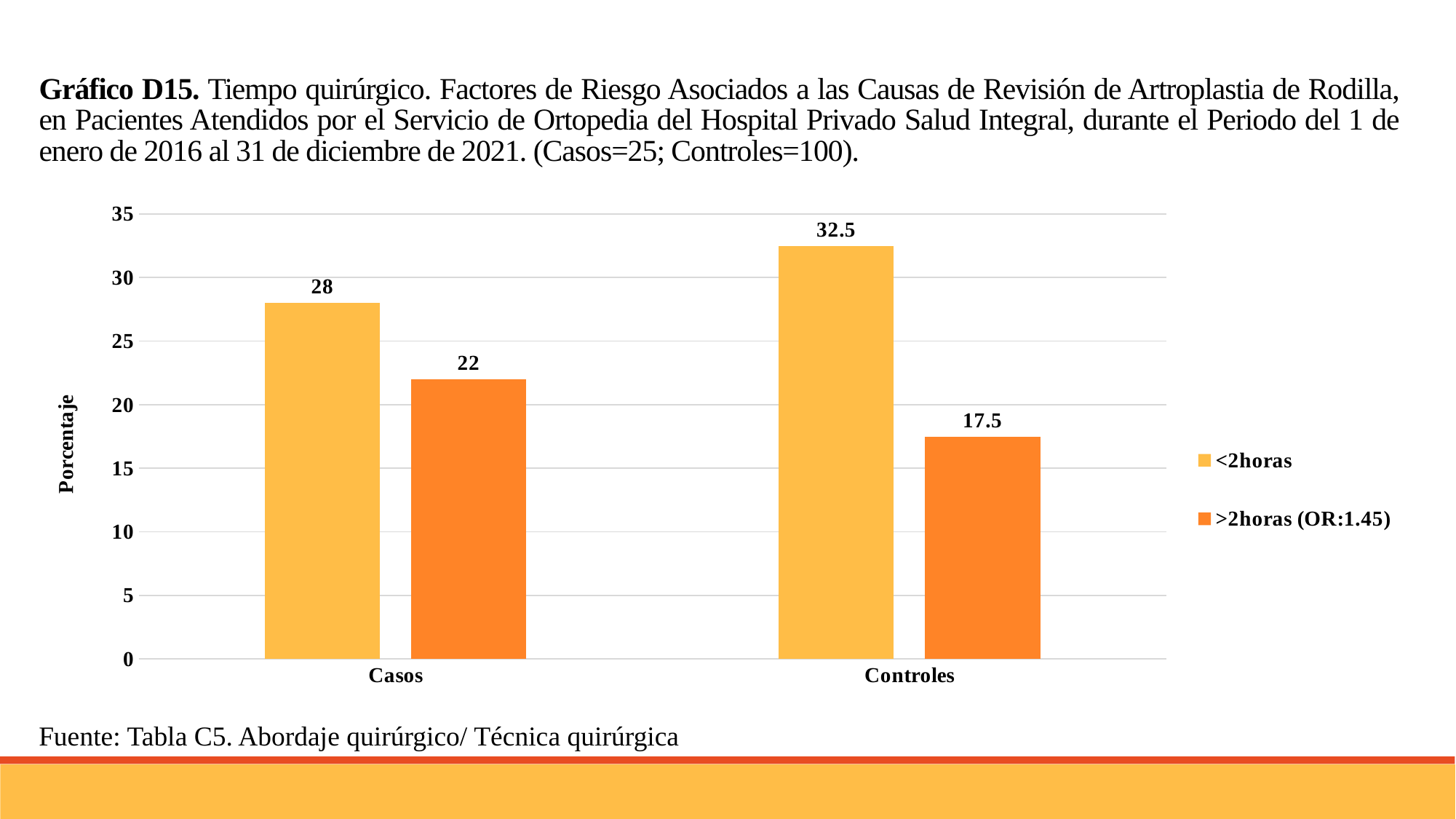
Which is larger, the >2horas (OR:1.45) value for Casos or for Controles? Casos What is the value for <2horas in the Casos category? 28 How many categories are shown on the x axis? 2 How many series does the legend list? 2 What is the difference between the <2horas and >2horas (OR:1.45) values in the Controles category? 15 What kind of chart is shown on the slide? Bar chart Which bar has the highest value on the chart? <2horas in Controles What is the difference between the <2horas values for Controles and Casos? 4.5 What is the value for >2horas (OR:1.45) in the Controles category? 17.5 Which bar has the lowest value on the chart? >2horas (OR:1.45) in Controles What is the value for >2horas (OR:1.45) in the Casos category? 22 What is the value for <2horas in the Controles category? 32.5